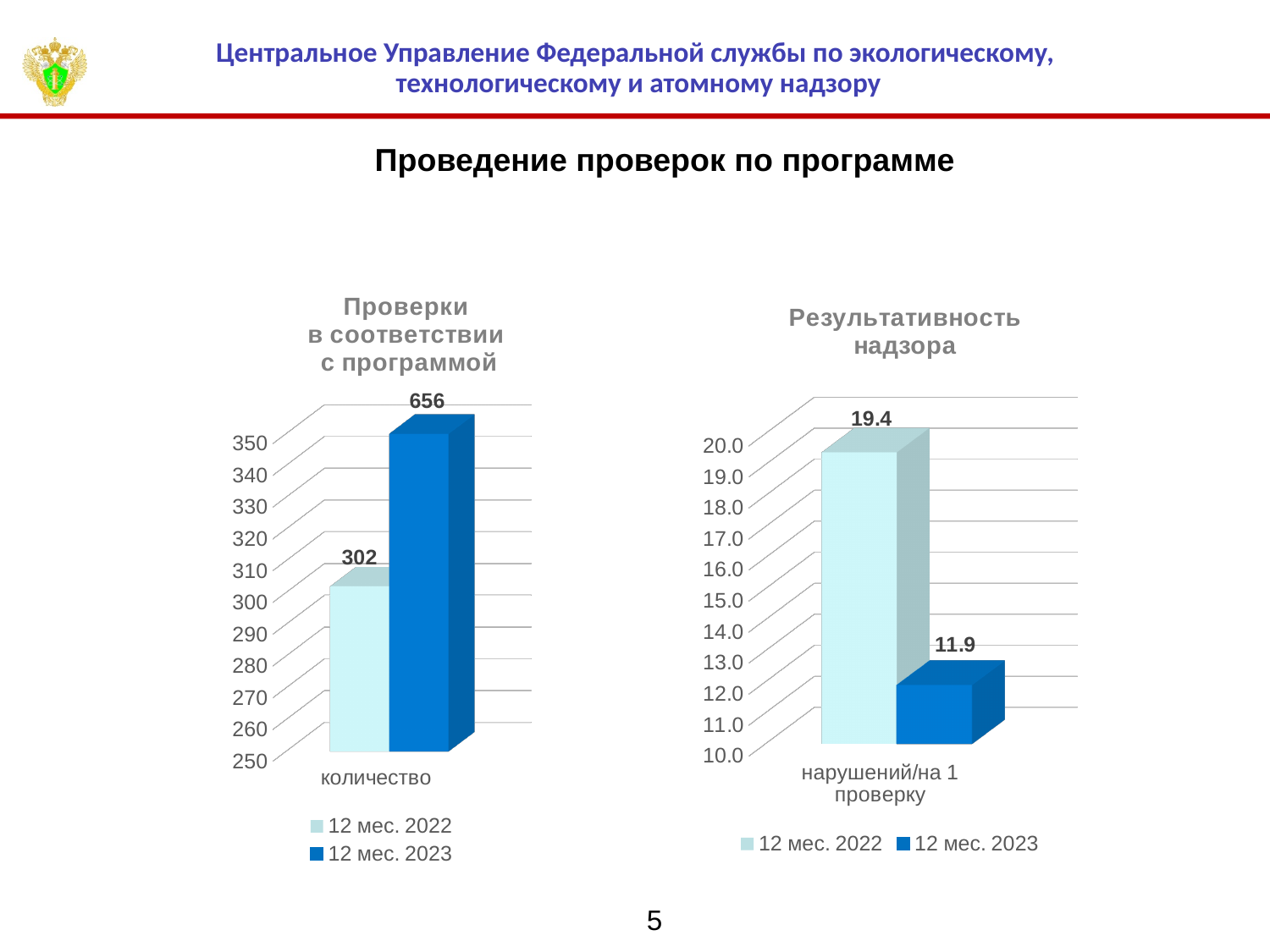
How many series does the legend of the chart titled "Результативность надзора" list? 2 In the chart titled "Проверки в соответствии с программой", what is the value for 12 мес. 2022? 302 In the chart titled "Результативность надзора", what is the value for 12 мес. 2022? 19.4 In the chart titled "Проверки в соответствии с программой", what is the difference between the 12 мес. 2023 and 12 мес. 2022 values? 354 What is the category label on the x axis of the chart titled "Результативность надзора"? нарушений/на 1 проверку In the chart titled "Проверки в соответствии с программой", what is the value for 12 мес. 2023? 656 In the chart titled "Результативность надзора", is the value for 12 мес. 2022 larger or smaller than the value for 12 мес. 2023? larger In the chart titled "Проверки в соответствии с программой", which series has the higher value? 12 мес. 2023 In the chart titled "Результативность надзора", what is the value for 12 мес. 2023? 11.9 What kind of chart is the chart titled "Проверки в соответствии с программой"? bar chart In the chart titled "Результативность надзора", which series has the lower value? 12 мес. 2023 In the chart titled "Результативность надзора", what is the difference between the 12 мес. 2022 and 12 мес. 2023 values? 7.5